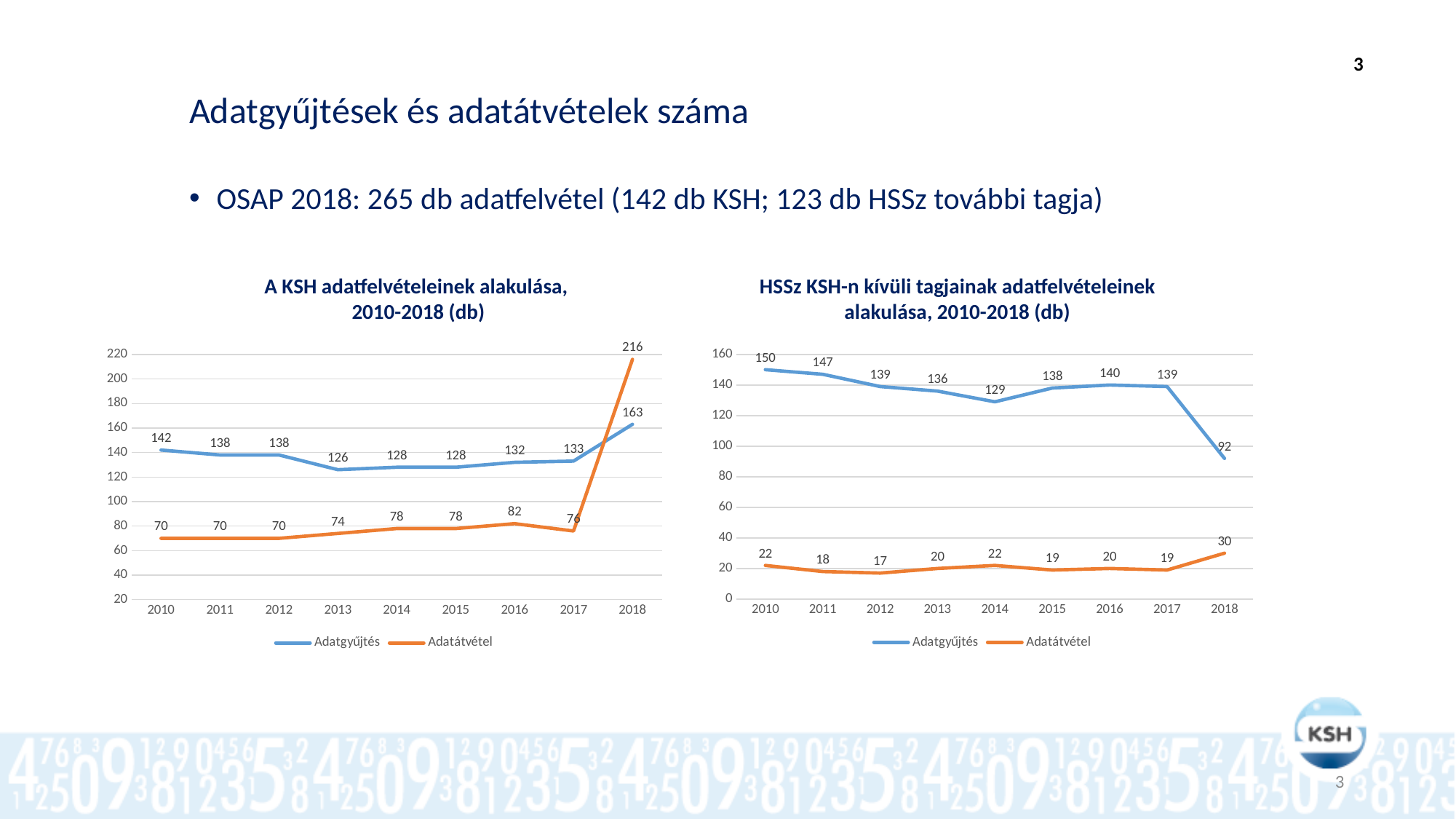
In the chart titled 'A KSH adatfelvételeinek alakulása, 2010-2018 (db)', what is the Adatgyűjtés value for 2013? 126 In the chart titled 'A KSH adatfelvételeinek alakulása, 2010-2018 (db)', how many years are shown on the x axis? 9 What kind of chart is the chart on the right of the slide? Line chart In the chart titled 'HSSz KSH-n kívüli tagjainak adatfelvételeinek alakulása, 2010-2018 (db)', does the Adatgyűjtés series rise or fall from 2017 to 2018? Fall In the chart titled 'HSSz KSH-n kívüli tagjainak adatfelvételeinek alakulása, 2010-2018 (db)', how many series does the legend list? 2 In the chart titled 'HSSz KSH-n kívüli tagjainak adatfelvételeinek alakulása, 2010-2018 (db)', in which year is the Adatátvétel series lowest? 2012 In the chart titled 'A KSH adatfelvételeinek alakulása, 2010-2018 (db)', in which year is the Adatgyűjtés series highest? 2018 In the chart titled 'A KSH adatfelvételeinek alakulása, 2010-2018 (db)', what is the difference between the Adatgyűjtés and Adatátvétel values in 2010? 72 In the chart titled 'A KSH adatfelvételeinek alakulása, 2010-2018 (db)', which series has the larger value in 2018, Adatgyűjtés or Adatátvétel? Adatátvétel In the chart titled 'A KSH adatfelvételeinek alakulása, 2010-2018 (db)', what is the Adatátvétel value for 2018? 216 In the chart titled 'HSSz KSH-n kívüli tagjainak adatfelvételeinek alakulása, 2010-2018 (db)', what is the Adatgyűjtés value for 2018? 92 In the chart titled 'HSSz KSH-n kívüli tagjainak adatfelvételeinek alakulása, 2010-2018 (db)', what is the difference between the Adatgyűjtés values for 2017 and 2018? 47